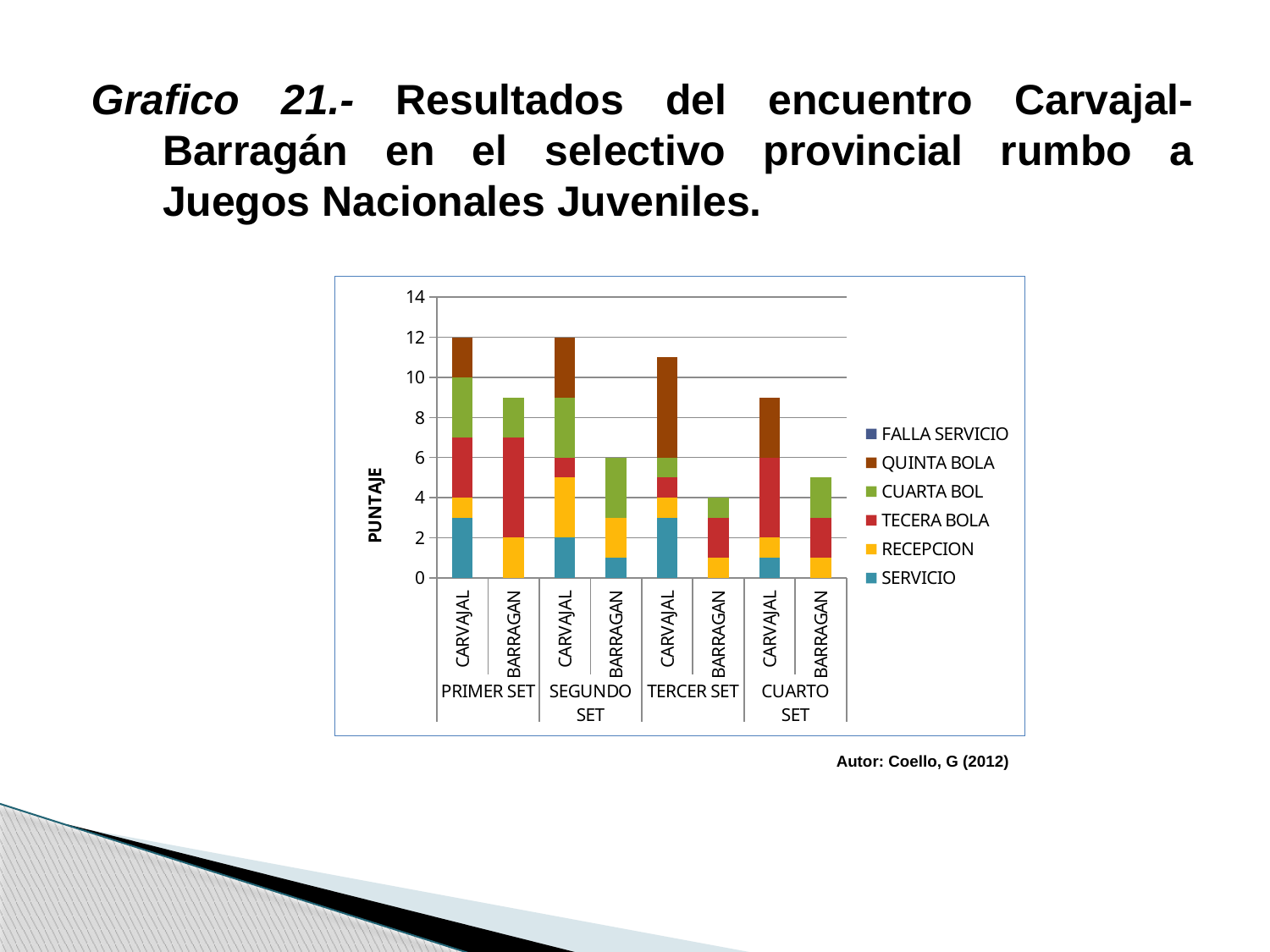
How many series does the legend list? 6 In PRIMER SET, which bar is taller, CARVAJAL or BARRAGAN? CARVAJAL Is the total for BARRAGAN in CUARTO SET greater or less than 6? less What is the total height of the BARRAGAN bar in SEGUNDO SET? 6 What is the total height of the BARRAGAN bar in TERCER SET? 4 How many bars are plotted in the chart? 8 What kind of chart is shown on the slide? stacked bar chart Which bar has the lowest total? BARRAGAN, TERCER SET Is the total for BARRAGAN in PRIMER SET greater or less than 8? greater What is the label of the vertical axis? PUNTAJE Is the total for CARVAJAL in TERCER SET greater or less than 10? greater What is the total height of the CARVAJAL bar in PRIMER SET? 12